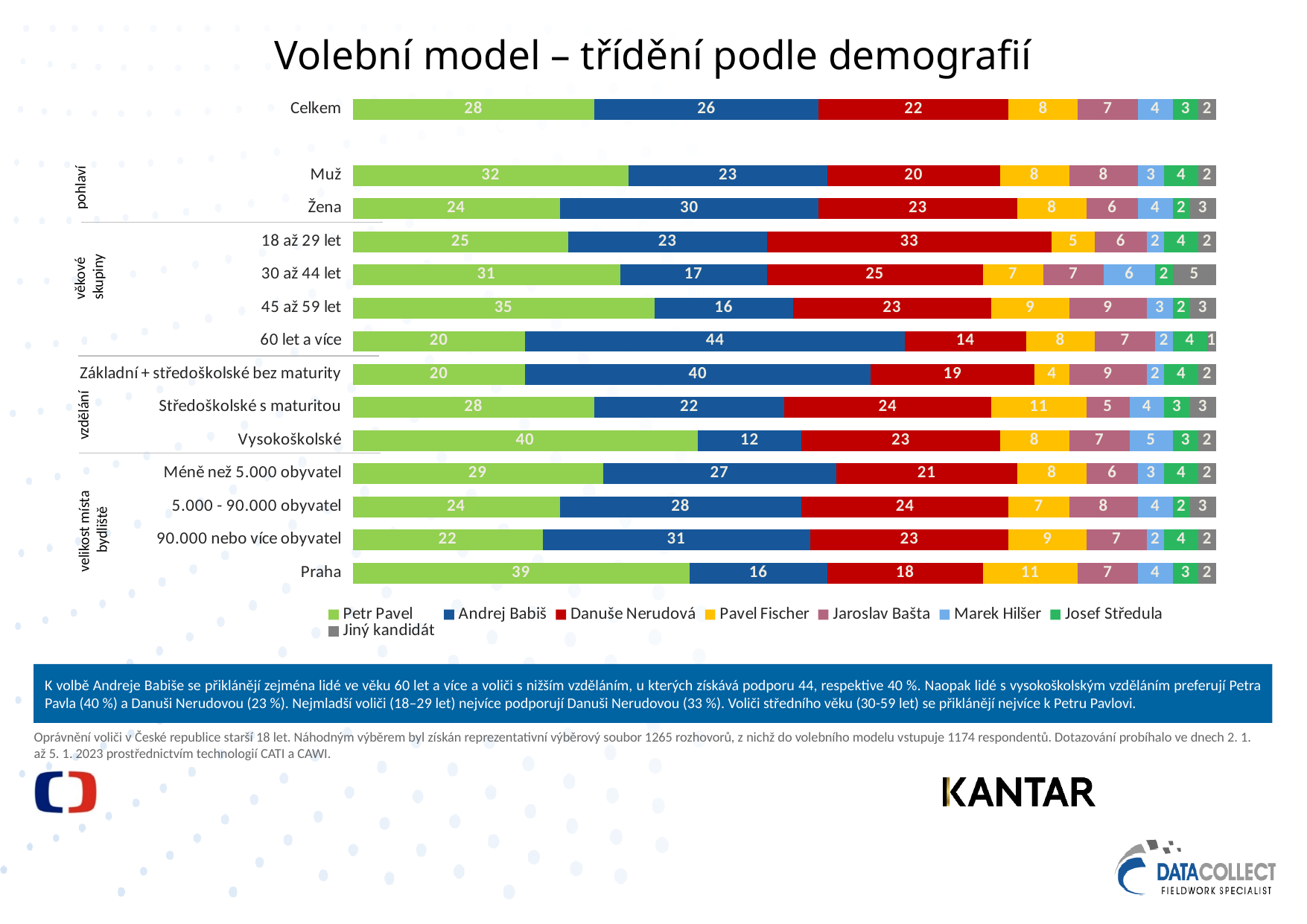
What is the total of the stacked bar for the Celkem category? 100 Which colour represents Petr Pavel in the chart? Light green What is the value for Danuše Nerudová in the '18 až 29 let' category? 33 In the Celkem category, what is the difference between the values for Petr Pavel and Andrej Babiš? 2 What is the value for Petr Pavel in the Praha category? 39 Which category has the lowest value for Andrej Babiš? Vysokoškolské Which category has the highest value for Petr Pavel? Vysokoškolské Is the value for Petr Pavel larger for Muž or for Žena? Muž What kind of chart is shown on the slide? Stacked bar chart What is the value for Andrej Babiš in the '60 let a více' category? 44 How many series does the legend list? 8 How many categories (bars) are shown in the chart? 14